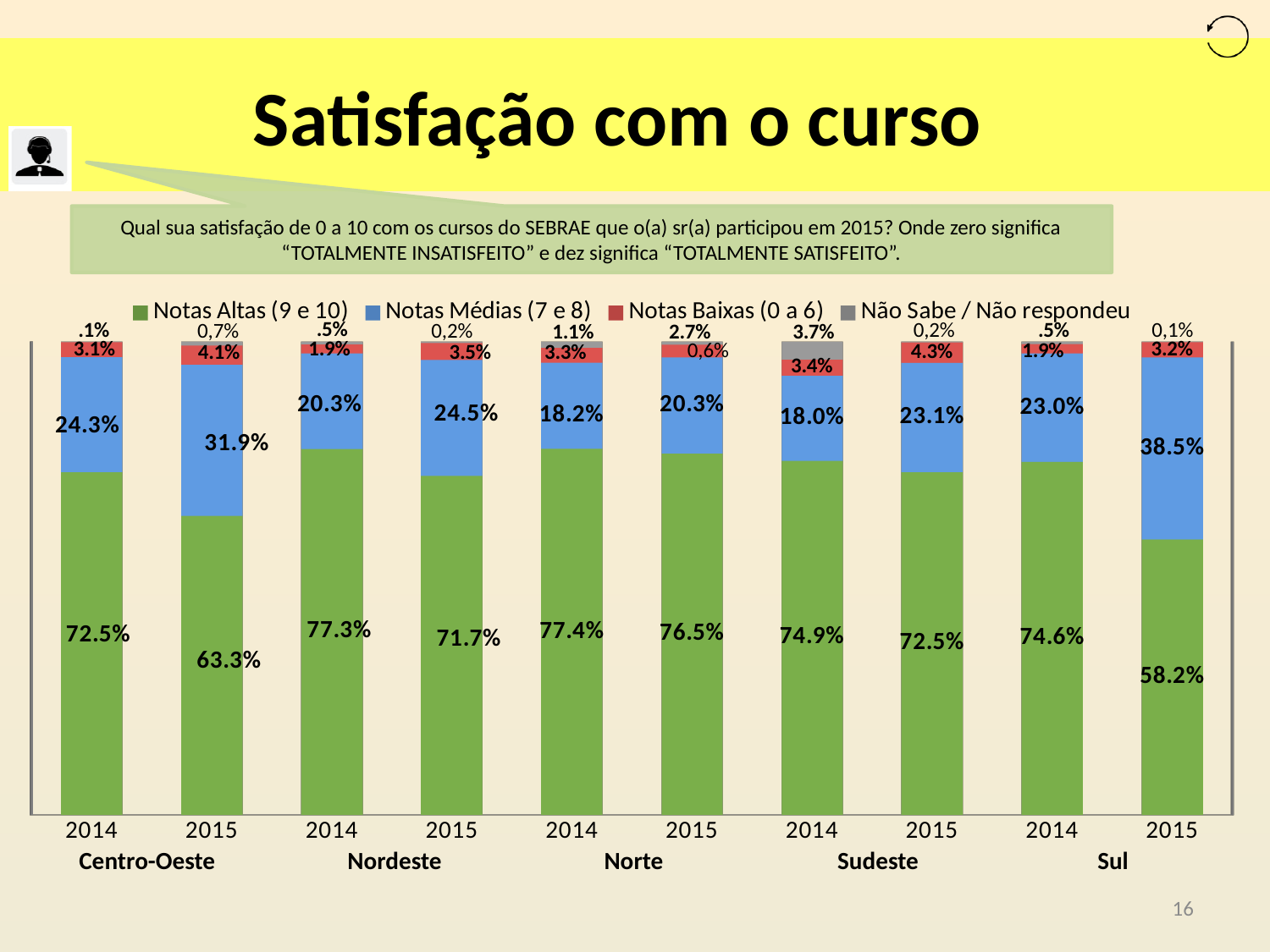
Which bar has the highest Notas Médias (7 e 8) share? Sul 2015 By how many percentage points did the Notas Altas (9 e 10) share in Sul fall from 2014 to 2015? 16.4 percentage points What kind of chart is shown on the slide? Stacked bar chart What is the Notas Baixas (0 a 6) value for Sudeste in 2015? 4.3% Which bar has the lowest Notas Altas (9 e 10) share? Sul 2015 What is the Notas Médias (7 e 8) value for Centro-Oeste in 2015? 31.9% How many series does the legend list? 4 Which is larger: the Notas Altas (9 e 10) share for Centro-Oeste in 2014 or in 2015? 2014 What is the Notas Altas (9 e 10) value for Nordeste in 2014? 77.3% What percentage of respondents in Sul in 2015 gave Notas Altas (9 e 10)? 58.2% What is the title of the slide? Satisfação com o curso How many bars are plotted in the chart? 10